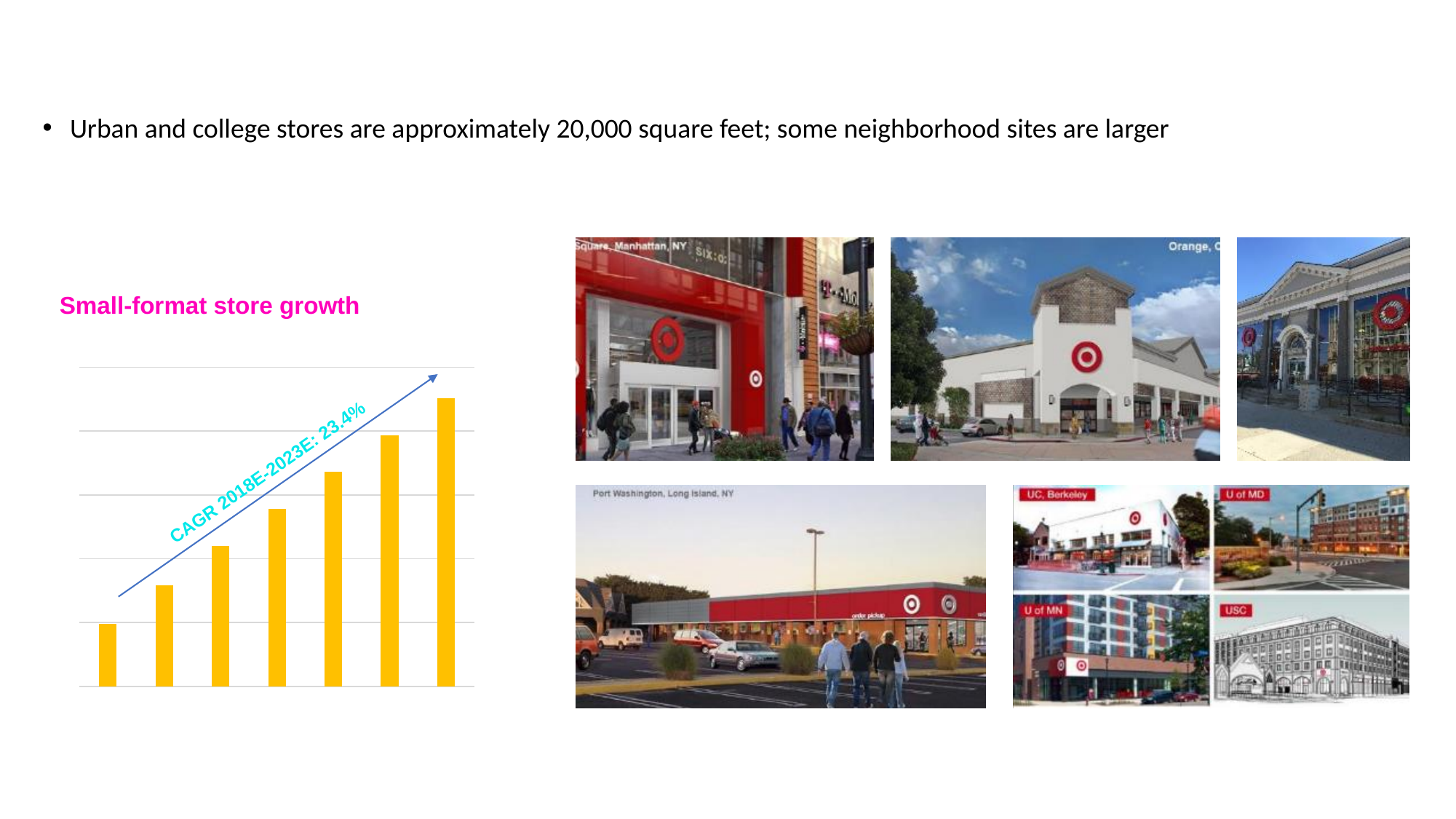
How many bars are plotted in the "Small-format store growth" chart? 7 Do the bars in the "Small-format store growth" chart rise or fall from left to right? rise What is the title of the chart on the left of the slide? Small-format store growth What CAGR for 2018E-2023E is annotated on the "Small-format store growth" chart? 23.4% What kind of chart is shown under the heading "Small-format store growth"? bar chart